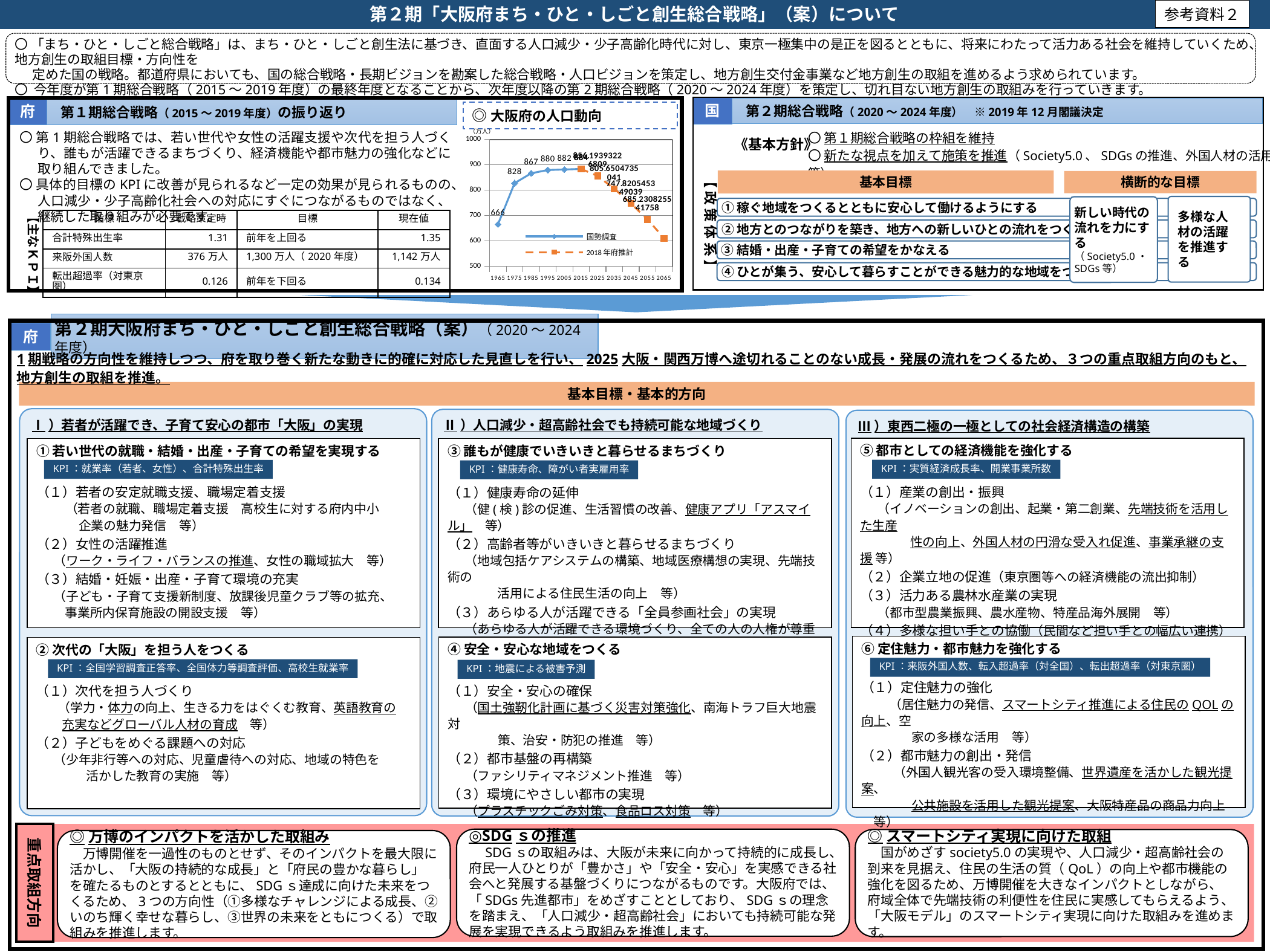
What kind of chart is the 大阪府の人口動向 chart? line chart What unit is shown at the top of the y axis of the 大阪府の人口動向 chart? 万人 In the 大阪府の人口動向 chart, what is the difference between the 国勢調査 values for 1975 and 1965? 162 In the 大阪府の人口動向 chart, which is larger, the 国勢調査 value for 1975 or for 1965? 1975 In the 大阪府の人口動向 chart, what is the 国勢調査 value for 1985? 867 How many series does the legend of the 大阪府の人口動向 chart list? 2 In the 大阪府の人口動向 chart, which year has the lowest 国勢調査 value? 1965 What is the title of the chart on the slide? 大阪府の人口動向 In the 大阪府の人口動向 chart, what is the 国勢調査 value for 1965? 666 In the 大阪府の人口動向 chart, is the 2018年推計 value for 2065 greater or less than 700? less In the 大阪府の人口動向 chart, what is the 国勢調査 value for 1975? 828 In the 大阪府の人口動向 chart, does the 2018年推計 series rise or fall from 2025 to 2065? fall